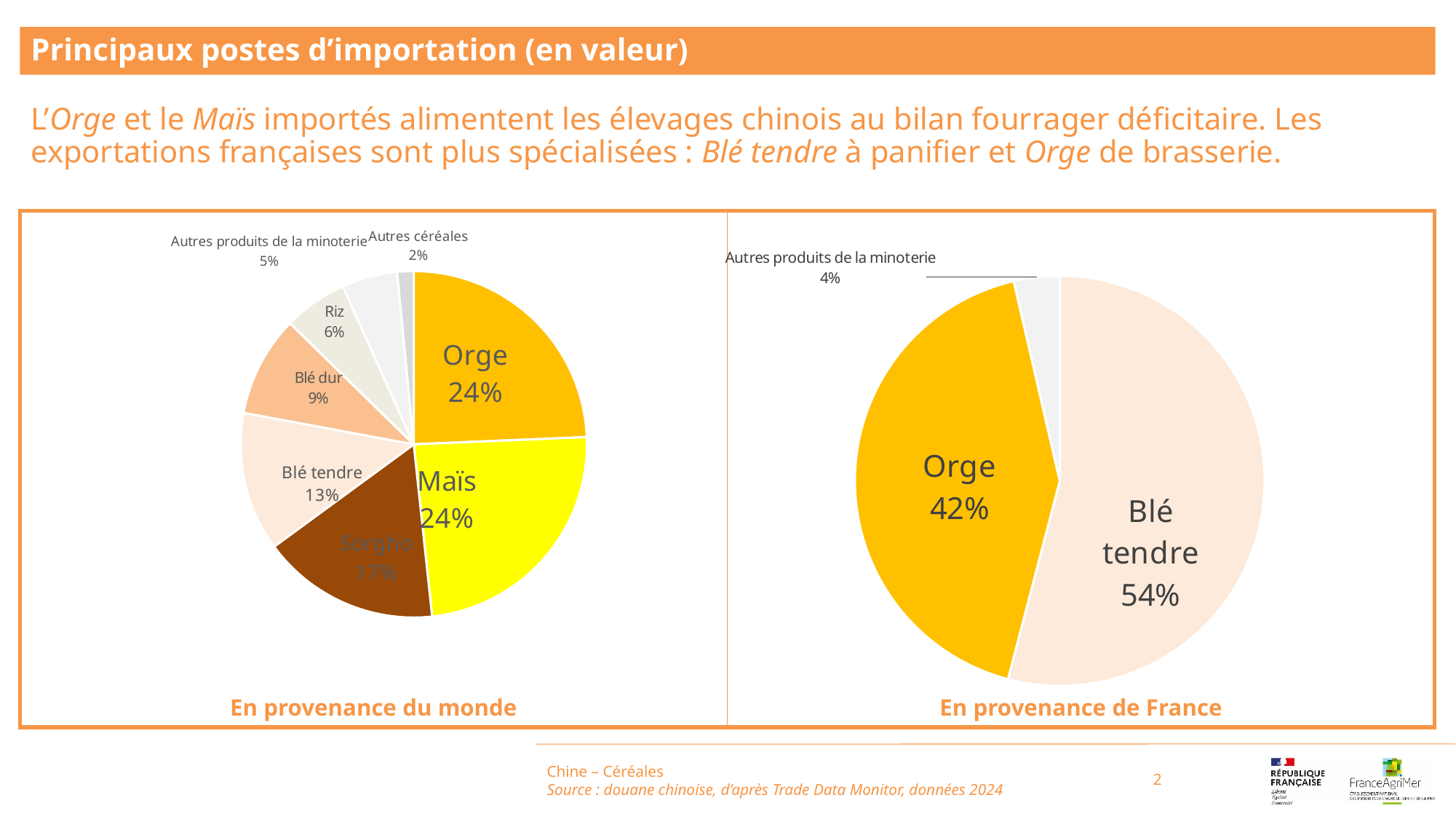
In the 'En provenance du monde' chart, what share does Sorgho have? 17% In the 'En provenance du monde' chart, which is larger, the share of Blé dur or the share of Riz? Blé dur In the 'En provenance du monde' chart, what share does Blé dur have? 9% In the 'En provenance du monde' chart, how many categories are shown? 8 In the 'En provenance de France' chart, which category has the largest share? Blé tendre In the 'En provenance du monde' chart, what share does Riz have? 6% What type of chart is used on this slide? Pie chart In the 'En provenance du monde' chart, what is the difference between the shares of Sorgho and Blé tendre? 4 percentage points In the 'En provenance de France' chart, what share does Orge have? 42% In the 'En provenance du monde' chart, which category has the smallest share? Autres céréales In the 'En provenance de France' chart, how many categories are shown? 3 In the 'En provenance de France' chart, what is the difference between the shares of Blé tendre and Orge? 12 percentage points